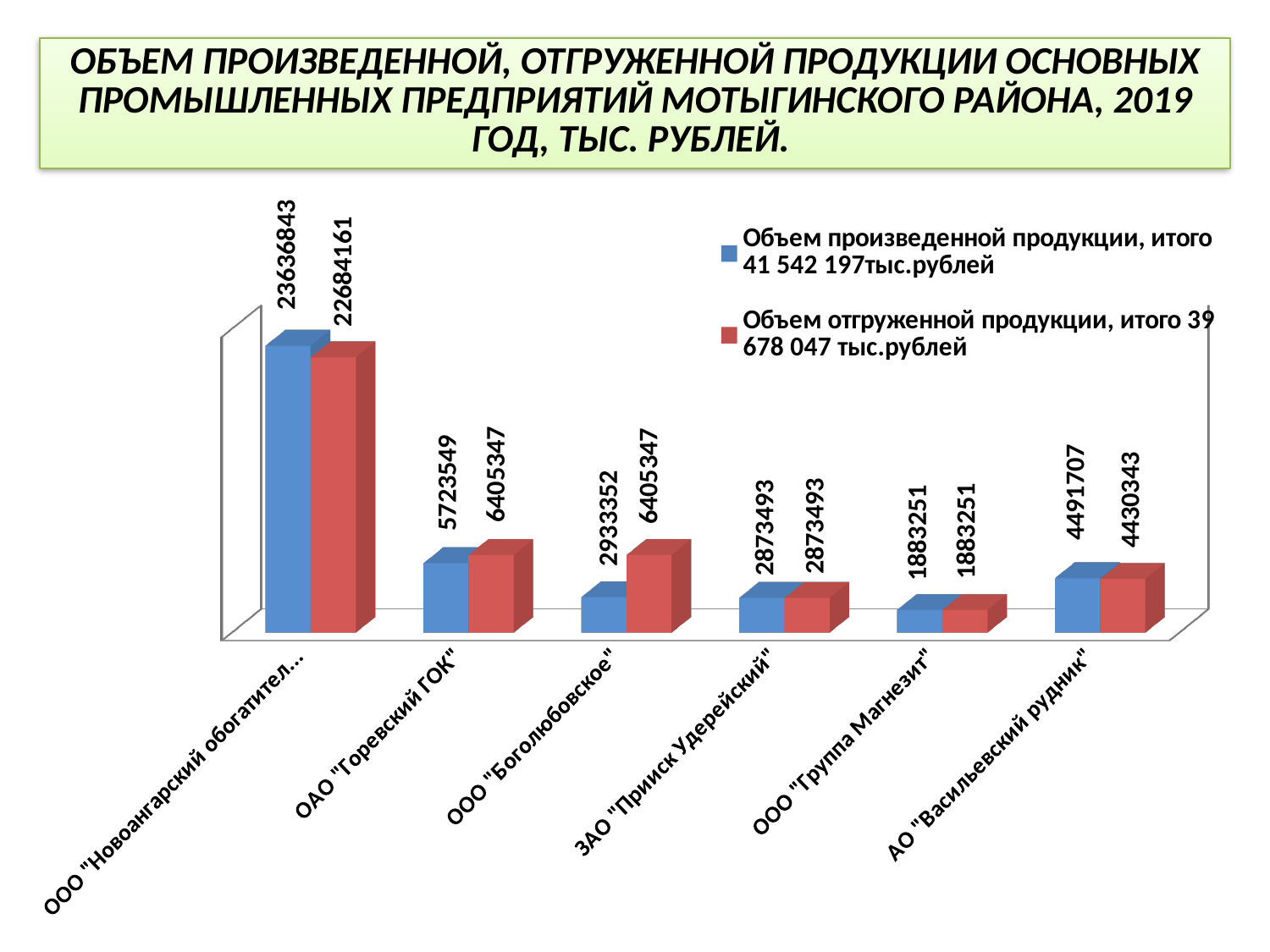
For ООО "Боголюбовское", what is the difference between Объем отгруженной продукции and Объем произведенной продукции? 3471995 What is the value of Объем произведенной продукции for ОАО "Горевский ГОК"? 5723549 How many enterprises (categories) are shown on the chart? 6 How many series does the legend list? 2 What is the value of Объем отгруженной продукции for ООО "Боголюбовское"? 6405347 For ОАО "Горевский ГОК", how much larger is Объем отгруженной продукции than Объем произведенной продукции? 681798 What type of chart is shown on the slide? Bar chart What is the value of Объем отгруженной продукции for ООО "Группа Магнезит"? 1883251 What is the value of Объем произведенной продукции for АО "Васильевский рудник"? 4491707 For АО "Васильевский рудник", which is larger: Объем произведенной продукции or Объем отгруженной продукции? Объем произведенной продукции Which enterprise has the lowest value of Объем отгруженной продукции? ООО "Группа Магнезит" According to the legend, what is the total Объем произведенной продукции? 41 542 197тыс.рублей